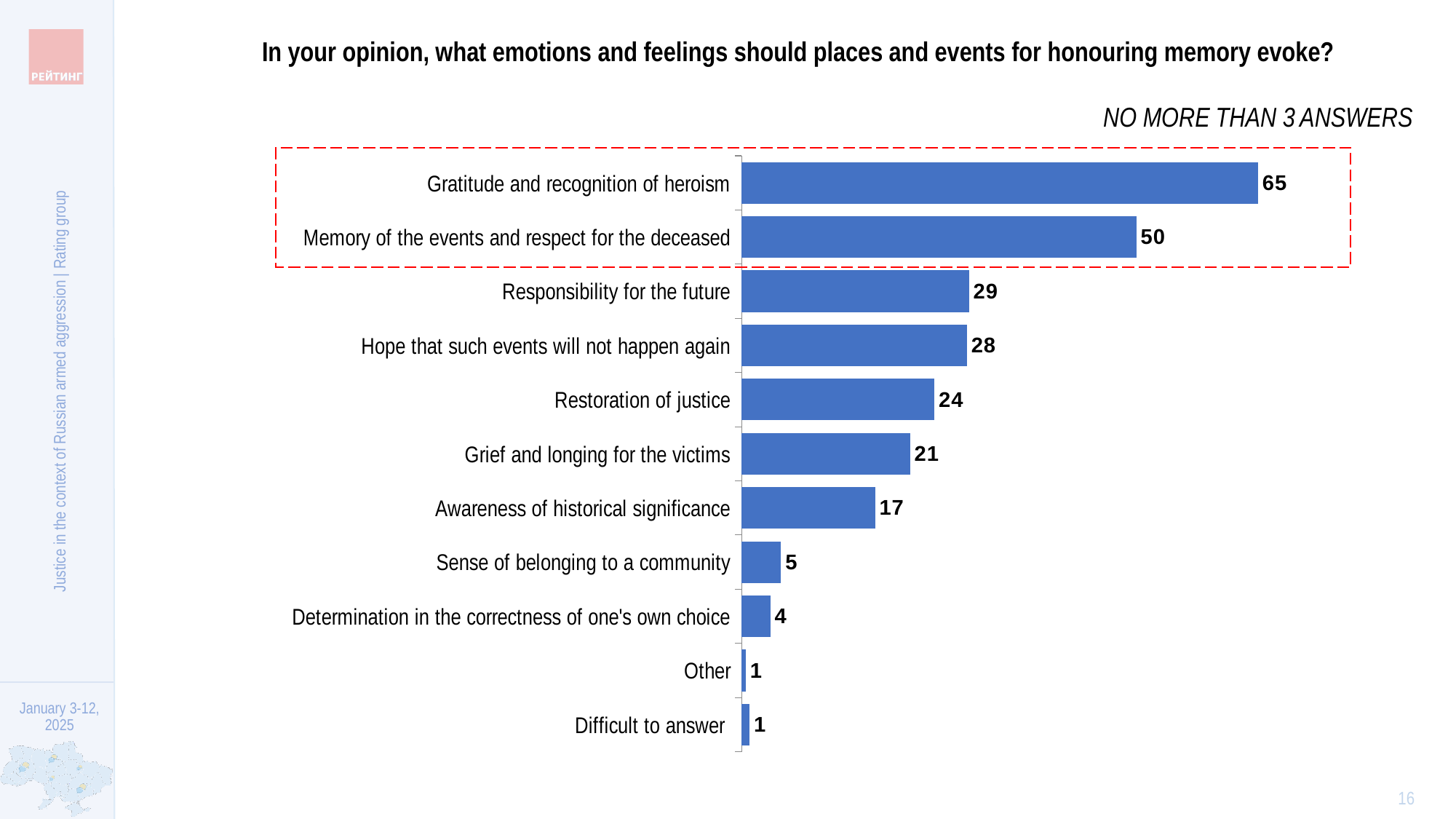
What is the difference between the values for "Grief and longing for the victims" and "Awareness of historical significance"? 4 What is the value for "Difficult to answer"? 1 What is the value for "Sense of belonging to a community"? 5 What is the value for "Gratitude and recognition of heroism"? 65 Which category has the highest value? Gratitude and recognition of heroism What is the value for "Hope that such events will not happen again"? 28 What is the difference between the values for "Gratitude and recognition of heroism" and "Memory of the events and respect for the deceased"? 15 How many categories are shown in the chart? 11 What kind of chart is shown on the slide? Bar chart What is the value for "Restoration of justice"? 24 Which two categories are enclosed by the red dashed box? Gratitude and recognition of heroism; Memory of the events and respect for the deceased Which is larger: the value for "Restoration of justice" or the value for "Grief and longing for the victims"? Restoration of justice